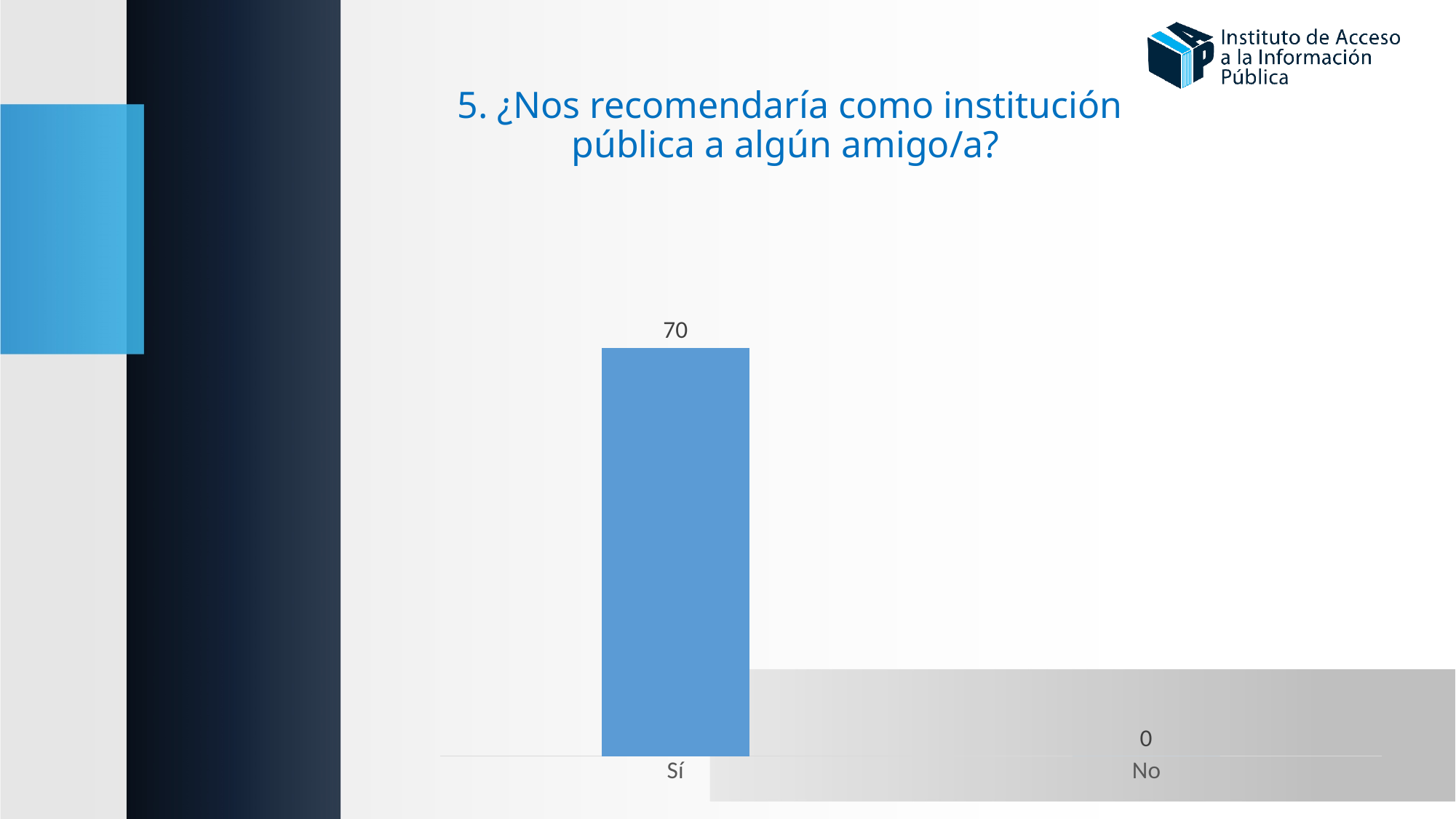
What colour is the bar for Sí? blue Which category has the lowest value? No Which category has the highest value? Sí Which is larger, the value for Sí or the value for No? Sí What is the difference between the values for Sí and No? 70 What kind of chart is shown on the slide? bar chart What is the total of the values for Sí and No? 70 What is the value for Sí? 70 How many categories are shown on the x axis? 2 What is the value for No? 0 What is the title of the slide above the chart? 5. ¿Nos recomendaría como institución pública a algún amigo/a?